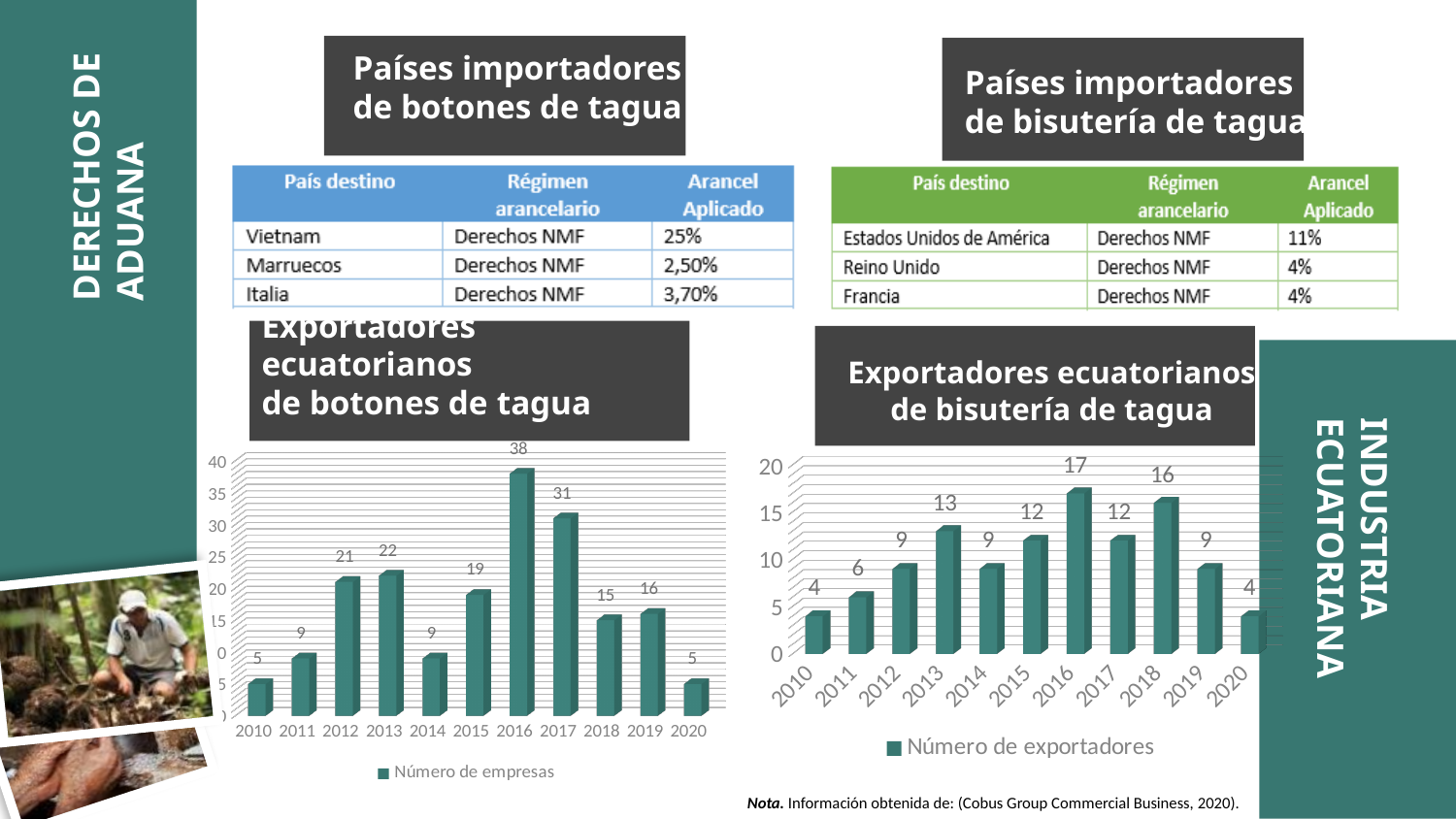
In the chart 'Exportadores ecuatorianos de bisutería de tagua', which is larger, the value for 2015 or the value for 2018? 2018 What kind of chart is 'Exportadores ecuatorianos de bisutería de tagua'? bar chart In the chart 'Exportadores ecuatorianos de botones de tagua', what is the legend entry? Número de empresas In the chart 'Exportadores ecuatorianos de botones de tagua', what is the value for 2016? 38 In the chart 'Exportadores ecuatorianos de botones de tagua', which year has the highest value? 2016 In the chart 'Exportadores ecuatorianos de botones de tagua', how many years are shown on the x axis? 11 In the chart 'Exportadores ecuatorianos de bisutería de tagua', is the value for 2018 greater or less than 15? greater In the chart 'Exportadores ecuatorianos de bisutería de tagua', which year has the highest value? 2016 In the chart 'Exportadores ecuatorianos de bisutería de tagua', what is the difference between the values for 2016 and 2019? 8 In the chart 'Exportadores ecuatorianos de bisutería de tagua', what is the value for 2013? 13 In the chart 'Exportadores ecuatorianos de botones de tagua', what is the difference between the values for 2017 and 2018? 16 In the chart 'Exportadores ecuatorianos de bisutería de tagua', how many series does the legend list? 1